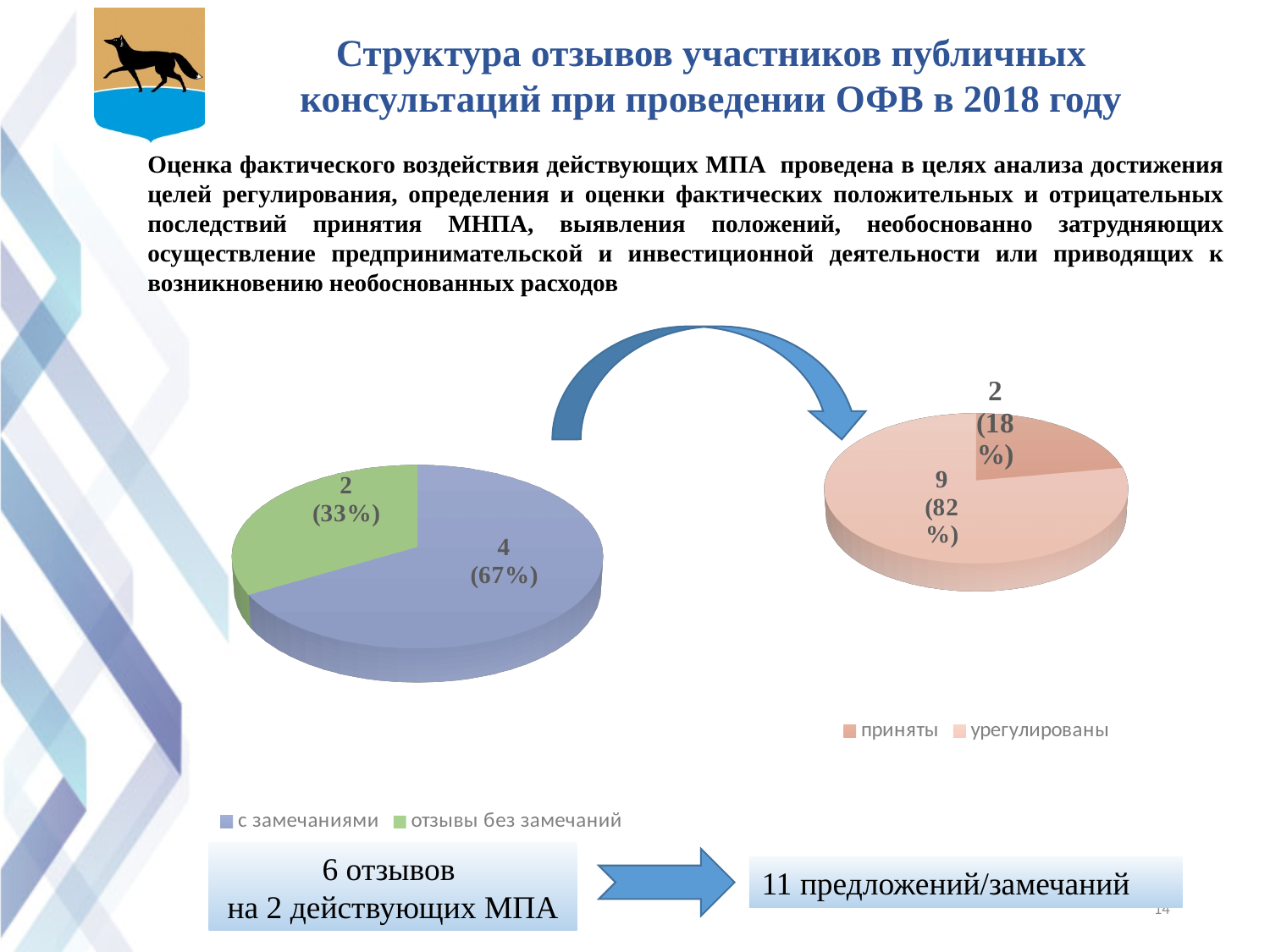
On the right pie chart, what is the difference between the values for 'урегулированы' and 'приняты'? 7 On the right pie chart, which slice is the smallest? приняты On the right pie chart, what value is shown for the slice 'приняты'? 2 (18%) On the left pie chart, what value is shown for the slice 'с замечаниями'? 4 (67%) On the left pie chart, which is larger: 'с замечаниями' or 'отзывы без замечаний'? с замечаниями How many slices does the right pie chart have? 2 On the left pie chart, what value is shown for the slice 'отзывы без замечаний'? 2 (33%) On the right pie chart, what value is shown for the slice 'урегулированы'? 9 (82%) On the right pie chart, what share of the pie does 'урегулированы' take? 82% What type of chart is the left chart on the slide? Pie chart On the left pie chart, what share of the pie does 'отзывы без замечаний' take? 33% On the left pie chart, which slice is the largest? с замечаниями